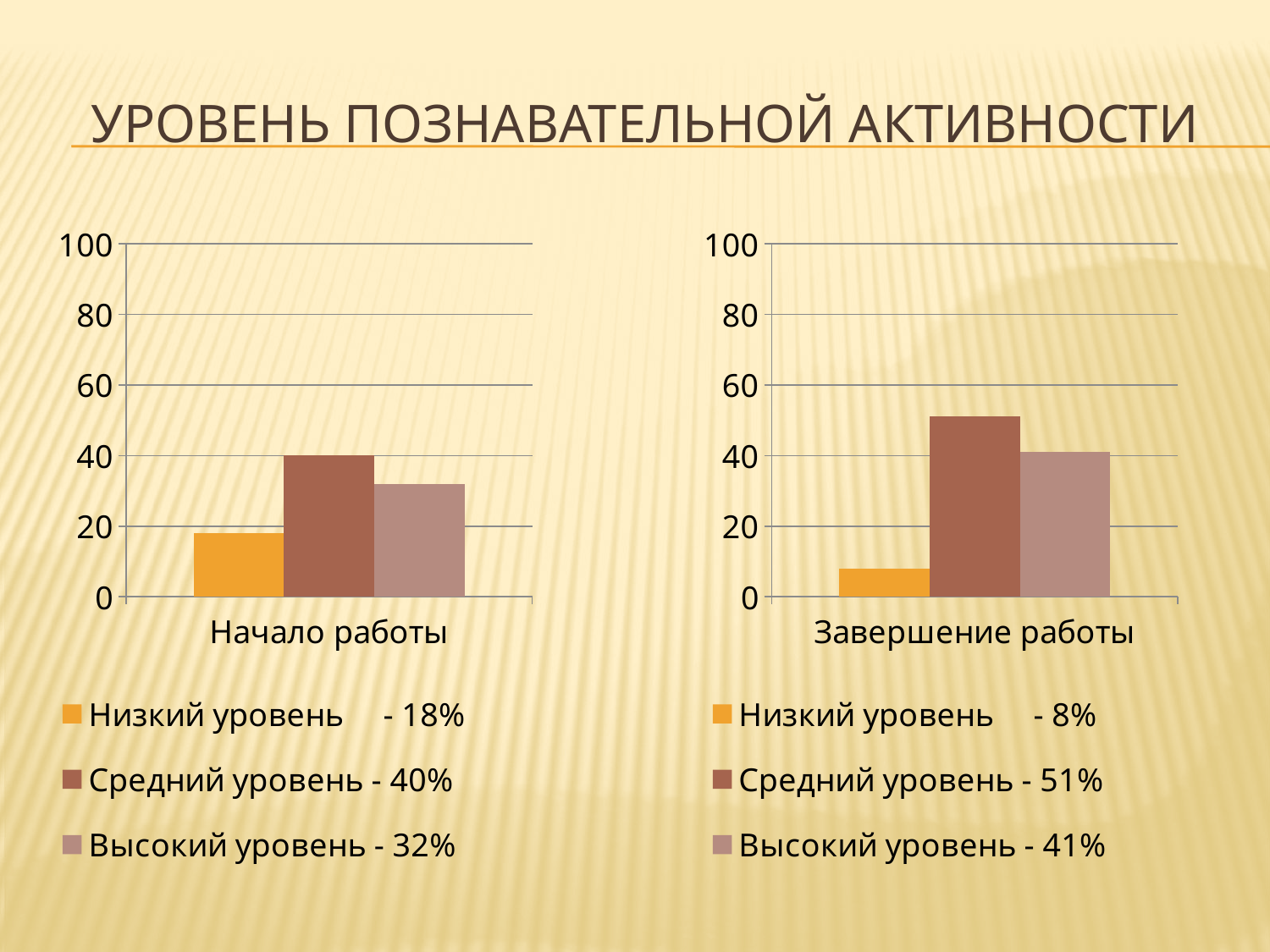
In the right chart (Завершение работы), what is the difference between Средний уровень and Высокий уровень? 10% In the left chart (Начало работы), what is the value for Низкий уровень? 18% What kind of chart is shown on the right (Завершение работы)? bar chart In the right chart (Завершение работы), is the value for Средний уровень greater or less than 40? greater How many series does the legend of the left chart (Начало работы) list? 3 In the right chart (Завершение работы), what is the value for Низкий уровень? 8% In the left chart (Начало работы), what is the difference between Средний уровень and Низкий уровень? 22% Which is larger: Высокий уровень in the left chart (Начало работы) or Высокий уровень in the right chart (Завершение работы)? Завершение работы In the left chart (Начало работы), which level has the highest value? Средний уровень In the right chart (Завершение работы), which level has the lowest value? Низкий уровень In the right chart (Завершение работы), what is the value for Высокий уровень? 41% In the left chart (Начало работы), what is the value for Средний уровень? 40%